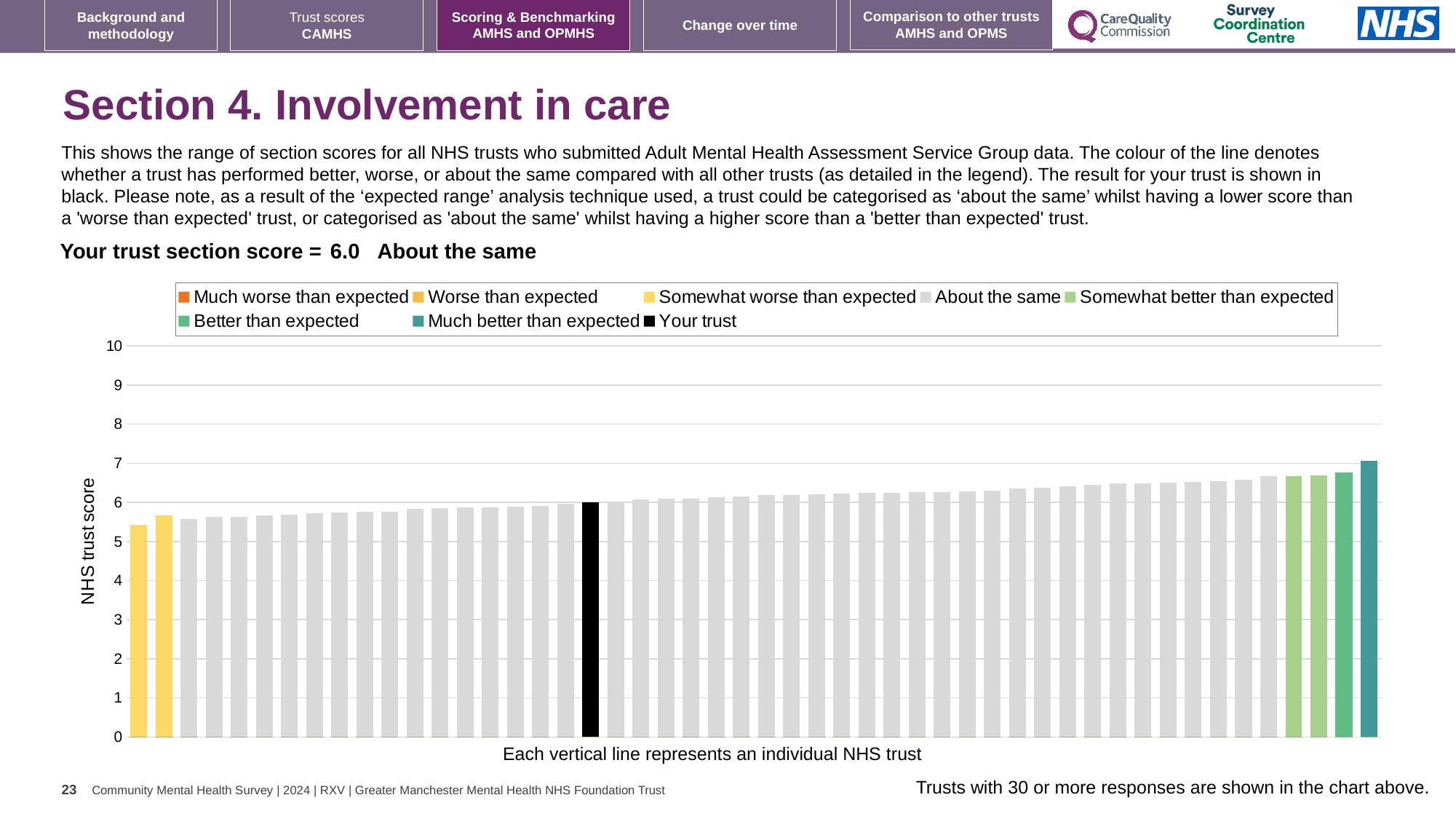
What is the label on the vertical axis of the chart? NHS trust score Which legend category does the tallest bar belong to? Much better than expected Is the value of the black 'Your trust' bar greater or less than 5? greater What is the section score for your trust shown on the slide? 6.0 Which legend category does the shortest bar belong to? Somewhat worse than expected Is the leftmost bar larger or smaller than the black 'Your trust' bar? Smaller Is the value of the leftmost bar greater or less than 6? less How many entries does the chart legend list? 8 What kind of chart is shown on the slide? Bar chart Do the bar values rise or fall from left to right across the chart? Rise Is the value of the rightmost bar greater or less than 6? greater